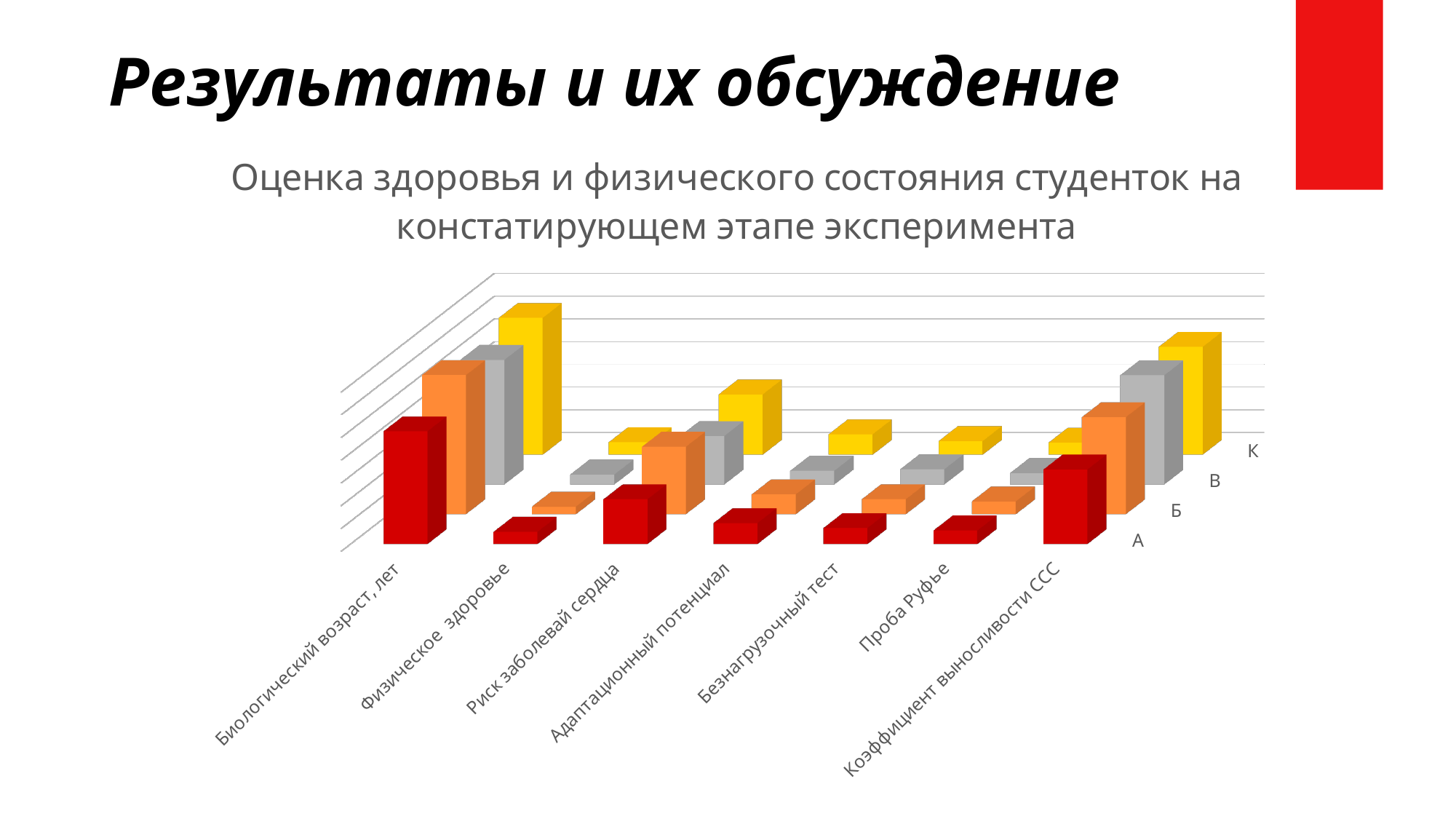
What are the labels of the series shown along the depth axis of the chart? А, Б, В, К For series В, which is larger: the value for Коэффициент выносливости ССС or the value for Безнагрузочный тест? Коэффициент выносливости ССС For series А, which is larger: the value for Биологический возраст, лет or the value for Физическое здоровье? Биологический возраст, лет How many series (groups) does the chart show along its depth axis? 4 How many categories are shown along the x axis of the chart? 7 What kind of chart is shown on the slide? bar chart For series А, which is larger: the value for Коэффициент выносливости ССС or the value for Проба Руфье? Коэффициент выносливости ССС What is the title of the chart? Оценка здоровья и физического состояния студенток на констатирующем этапе эксперимента